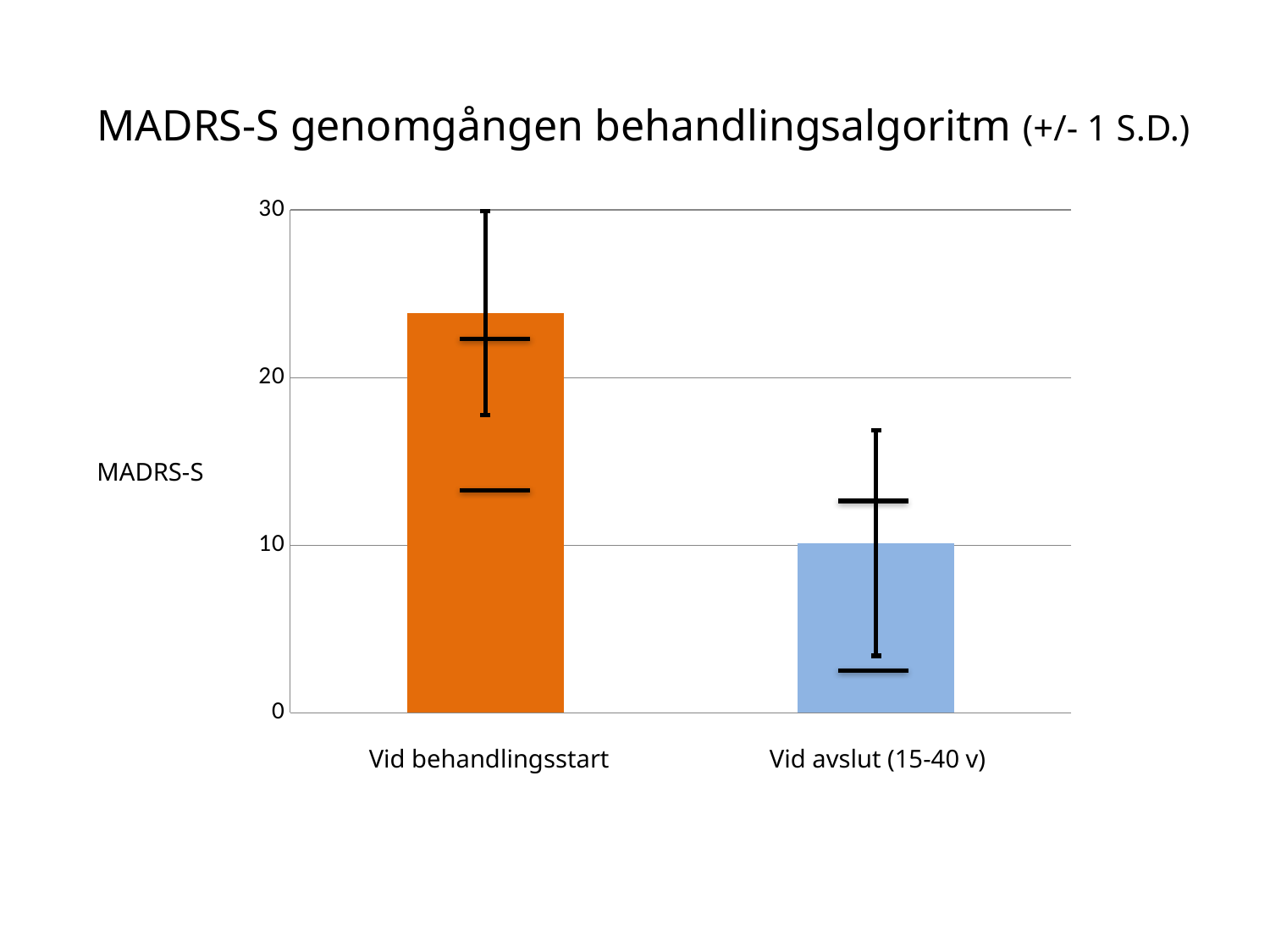
Which category has the lowest MADRS-S value? Vid avslut (15-40 v) Is the value for Vid behandlingsstart greater or less than 30? less Which category has the highest MADRS-S value? Vid behandlingsstart Is the value for Vid avslut (15-40 v) greater or less than 20? less How many categories are shown on the x axis? 2 Is the value for Vid behandlingsstart greater or less than 20? greater Which is larger, the value for Vid behandlingsstart or the value for Vid avslut (15-40 v)? Vid behandlingsstart What kind of chart is shown on the slide? bar chart Do the values rise or fall from Vid behandlingsstart to Vid avslut (15-40 v)? fall What is the title of the chart? MADRS-S genomgången behandlingsalgoritm (+/- 1 S.D.) What is the label on the y axis? MADRS-S